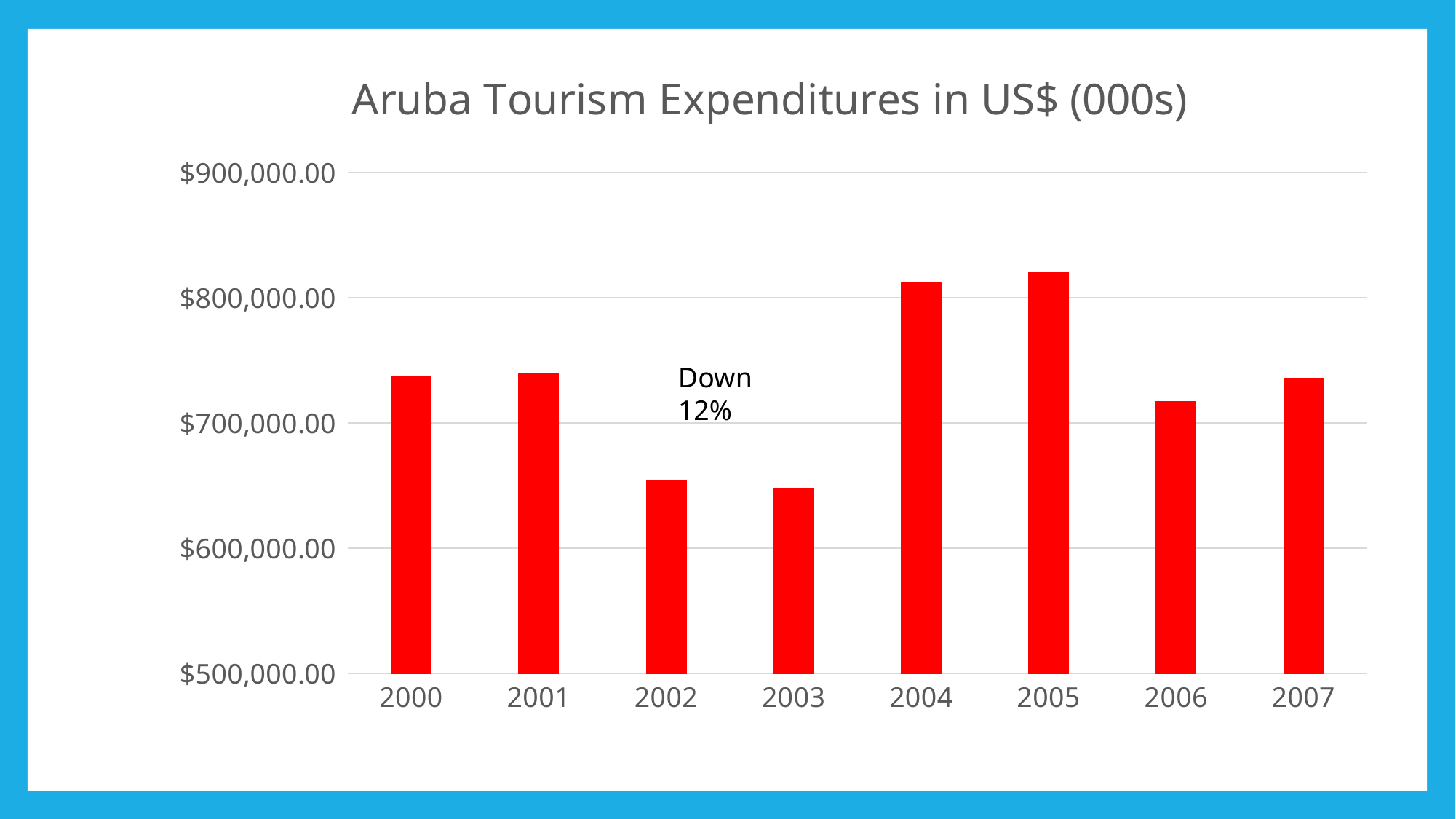
What kind of chart is shown on the slide? Bar chart What is the title of the chart? Aruba Tourism Expenditures in US$ (000s) How many years are plotted on the x axis? 8 Do the values rise or fall from 2001 to 2002? fall Is the value for 2006 greater or less than $700,000.00? greater Which year has the larger value, 2003 or 2007? 2007 What does the text annotation above the 2002 bar say? Down 12% Is the value for 2002 greater or less than $700,000.00? less Is the value for 2004 greater or less than $800,000.00? greater Which year has the highest tourism expenditure? 2005 Which year has the larger value, 2004 or 2002? 2004